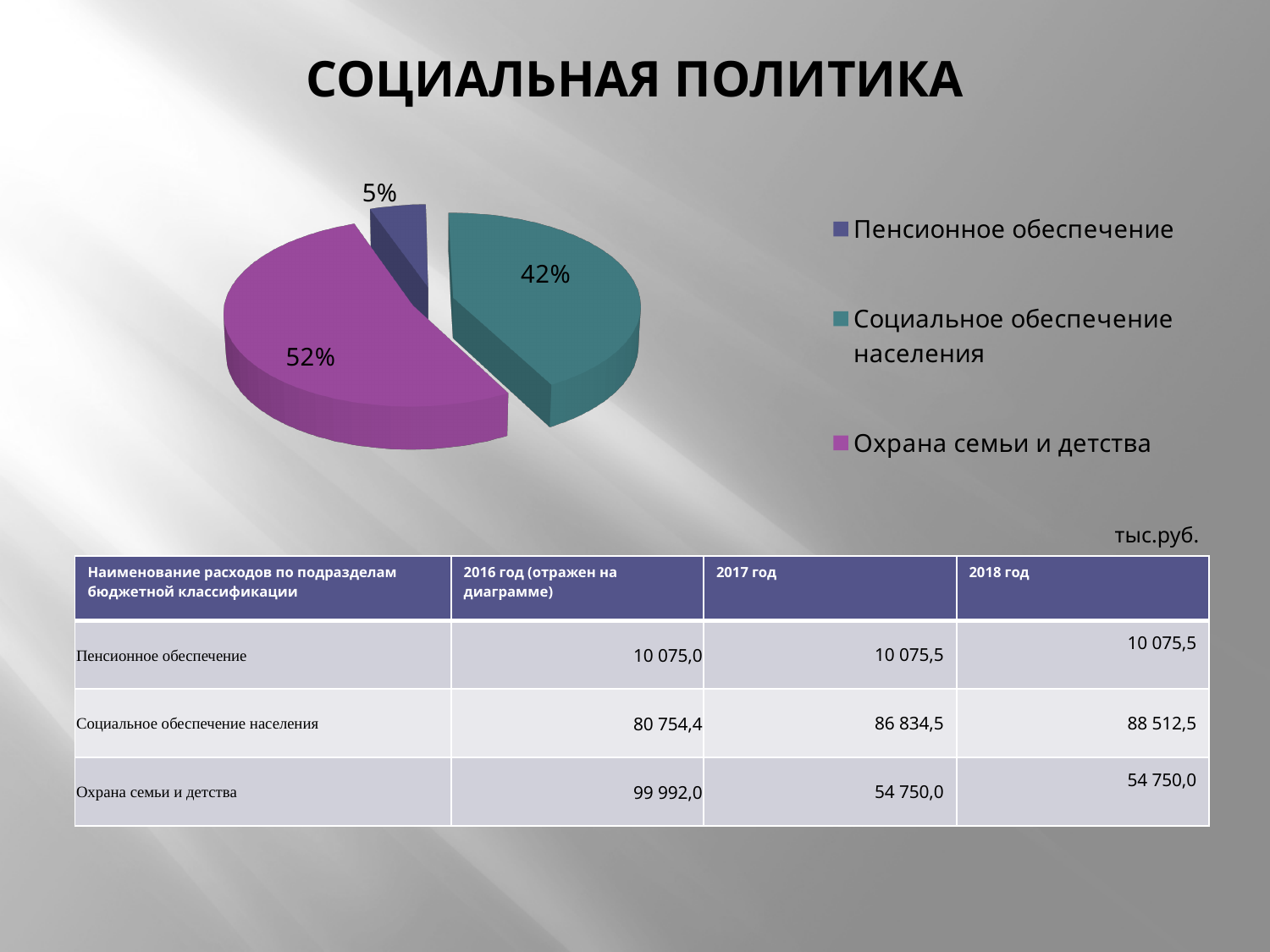
What kind of chart is shown on the slide? Pie chart Which category has the largest slice of the pie? Охрана семьи и детства Which category has the smallest slice of the pie? Пенсионное обеспечение What is the difference in percentage points between the slices for Охрана семьи и детства and Социальное обеспечение населения? 10 Which is larger: the slice for Социальное обеспечение населения or the slice for Охрана семьи и детства? Охрана семьи и детства What is the difference in percentage points between the slices for Социальное обеспечение населения and Пенсионное обеспечение? 37 What share of the pie does Социальное обеспечение населения take? 42% What share of the pie does Пенсионное обеспечение take? 5% How many entries does the legend list? 3 How many slices does the pie chart have? 3 What share of the pie does Охрана семьи и детства take? 52% What is the title of the slide containing the pie chart? СОЦИАЛЬНАЯ ПОЛИТИКА